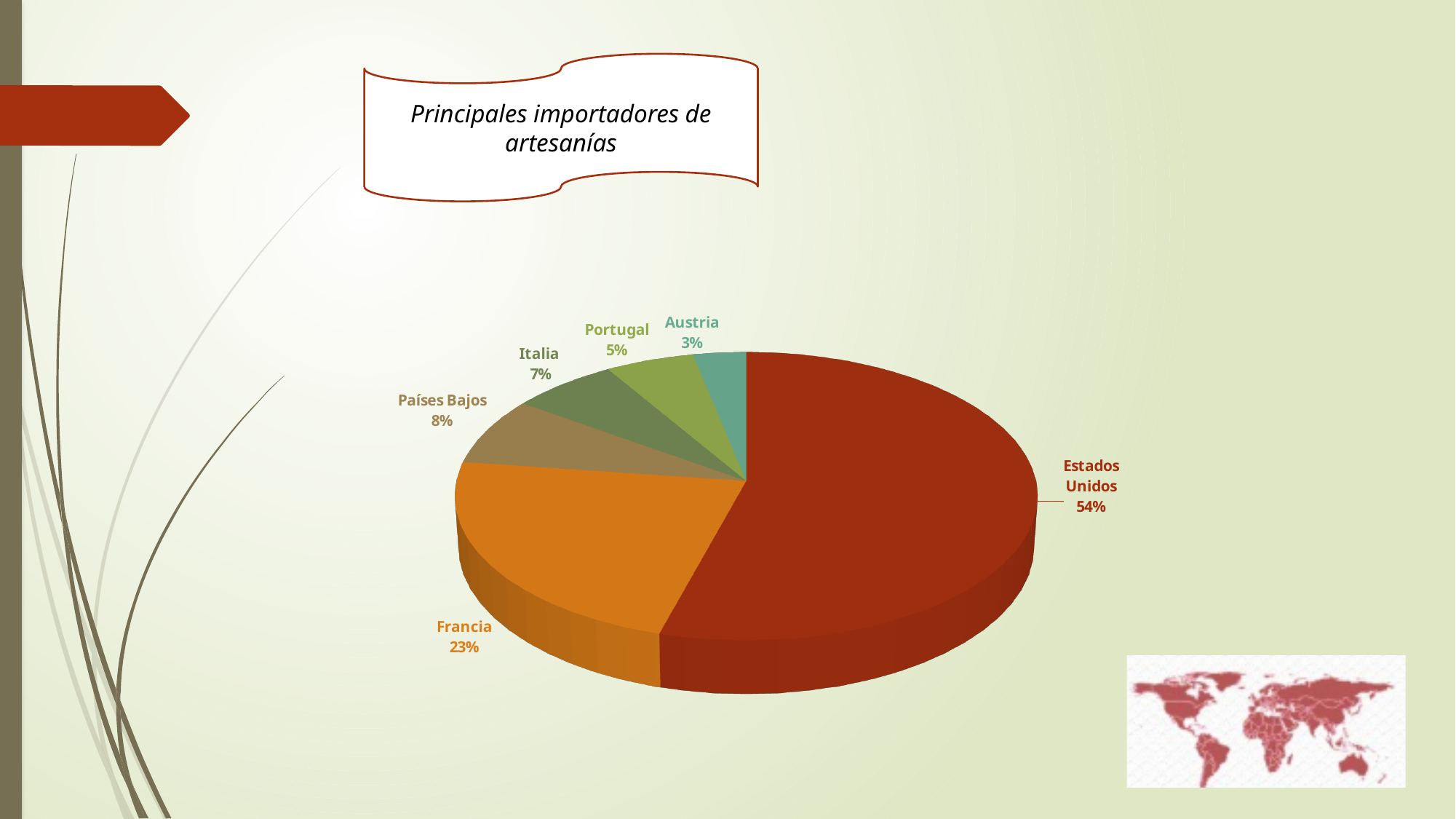
What share of the pie does Estados Unidos hold? 54% Which country has the largest slice of the pie? Estados Unidos What is the value shown for Países Bajos? 8% Which has a larger share, Países Bajos or Italia? Países Bajos What is the value shown for Italia? 7% Which country has the smallest slice of the pie? Austria What is the value shown for Portugal? 5% What kind of chart is shown on the slide? Pie chart How many countries are shown in the pie chart? 6 What is the difference between the shares of Estados Unidos and Francia? 31% What is the value shown for Francia? 23% What is the title shown above the chart? Principales importadores de artesanías